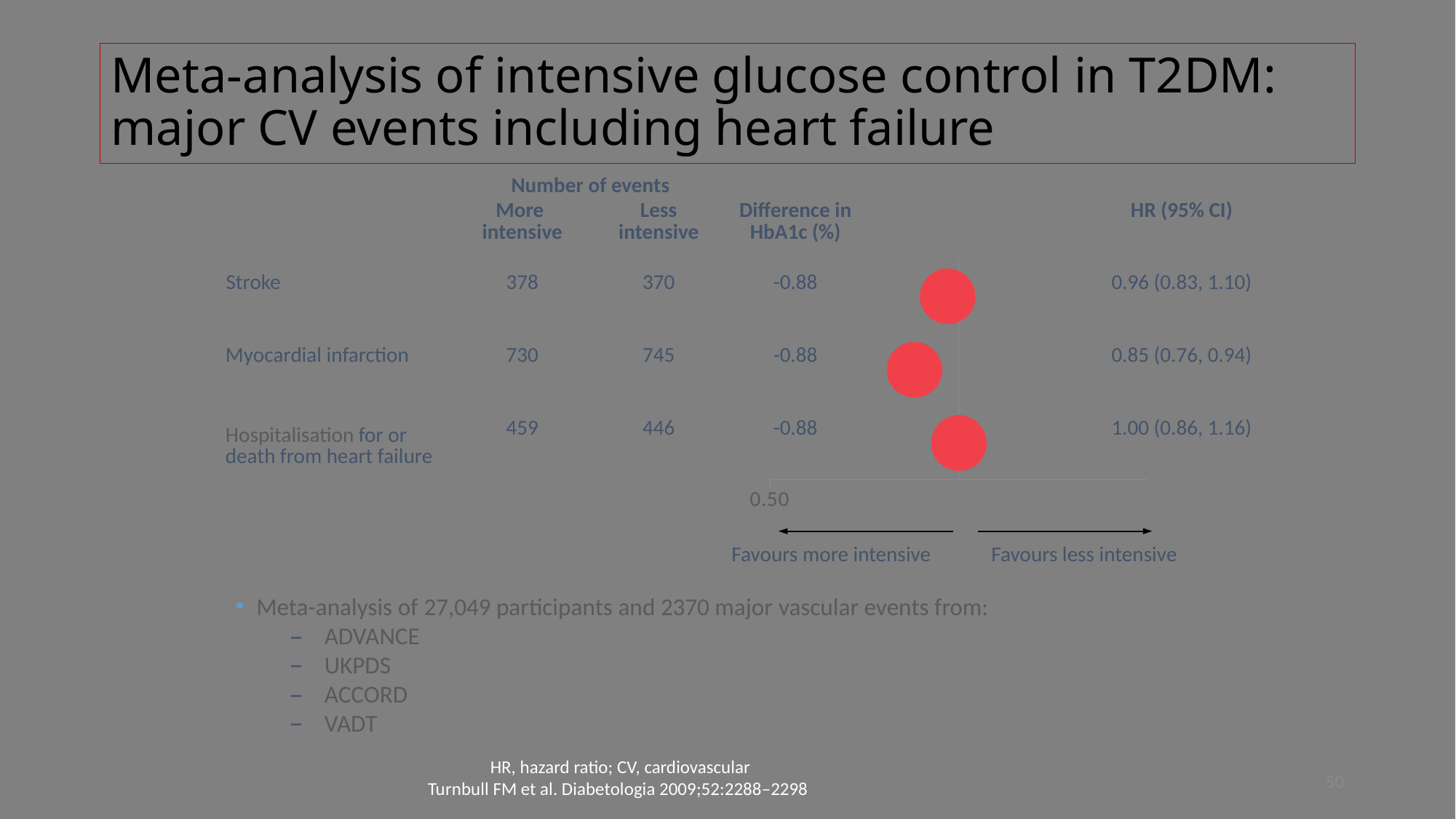
What is the hazard ratio (95% CI) plotted for Myocardial infarction? 0.85 (0.76, 0.94) What is the difference between the hazard ratio for Hospitalisation for or death from heart failure and the hazard ratio for Myocardial infarction? 0.15 How many outcomes are plotted in the forest plot? 3 Which outcome has the lowest hazard ratio in the forest plot? Myocardial infarction What is the hazard ratio (95% CI) plotted for Hospitalisation for or death from heart failure? 1.00 (0.86, 1.16) What is the hazard ratio (95% CI) plotted for Stroke? 0.96 (0.83, 1.10) Is the hazard ratio for Stroke larger or smaller than the hazard ratio for Myocardial infarction? larger Is the hazard ratio for Myocardial infarction greater or less than 0.50? greater What is the difference in HbA1c (%) shown for Myocardial infarction? -0.88 How many events were recorded for Stroke in the more intensive group? 378 What does the left side of the forest plot axis favour, according to the label below it? Favours more intensive Which outcome has the highest hazard ratio in the forest plot? Hospitalisation for or death from heart failure